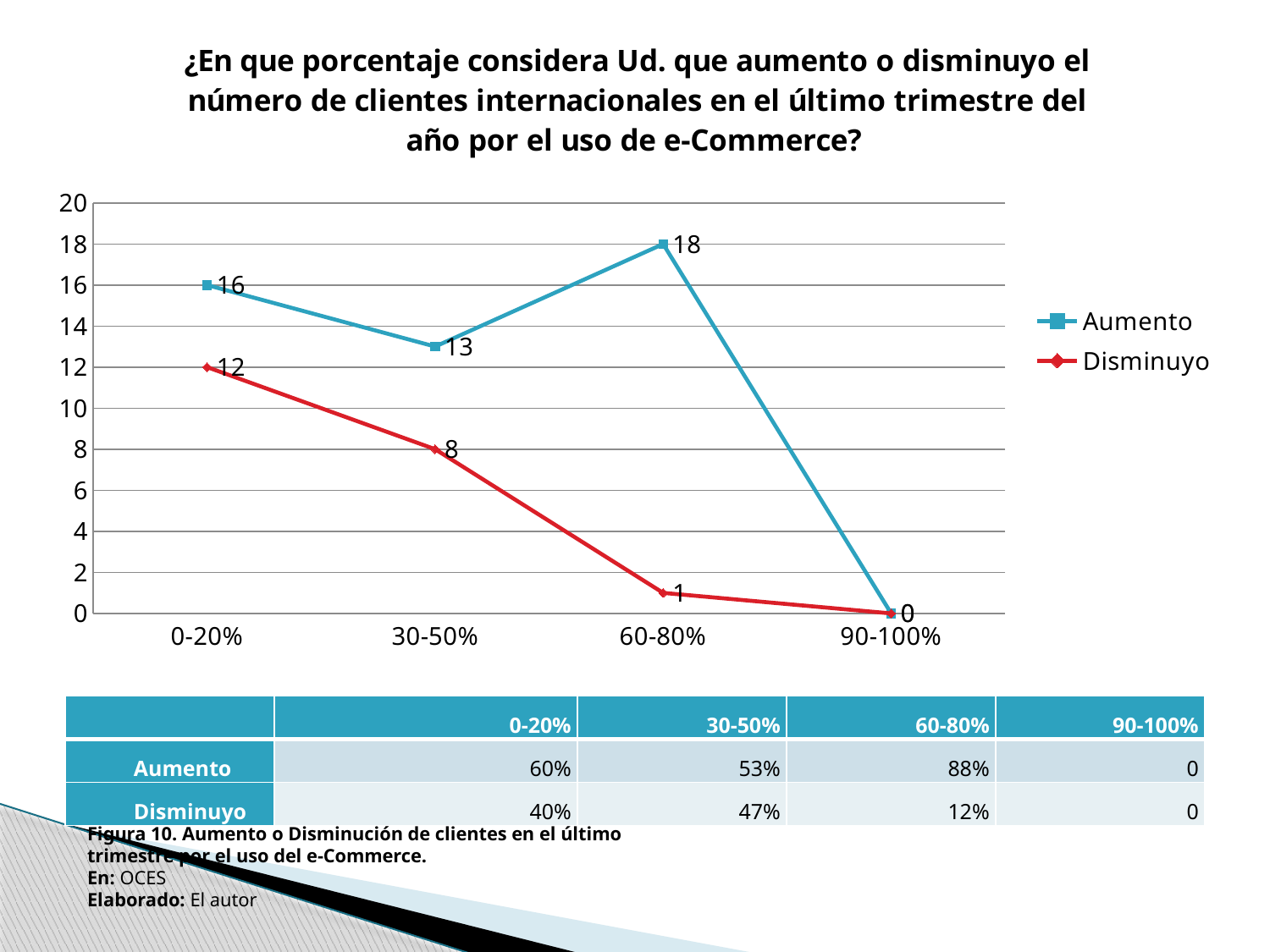
What kind of chart is shown? Line chart What is the value for Aumento at 30-50%? 13 Does the Disminuyo series rise or fall from 0-20% to 90-100%? Fall What is the value for Aumento at 60-80%? 18 What colour is the Disminuyo line? Red What is the difference between Aumento and Disminuyo at 0-20%? 4 At which category does the Aumento series reach its highest value? 60-80% What is the value for Disminuyo at 30-50%? 8 At which category does the Disminuyo series have its lowest value? 90-100% Which series has the larger value at 60-80%, Aumento or Disminuyo? Aumento How many categories are shown on the x axis? 4 How many series does the legend list? 2